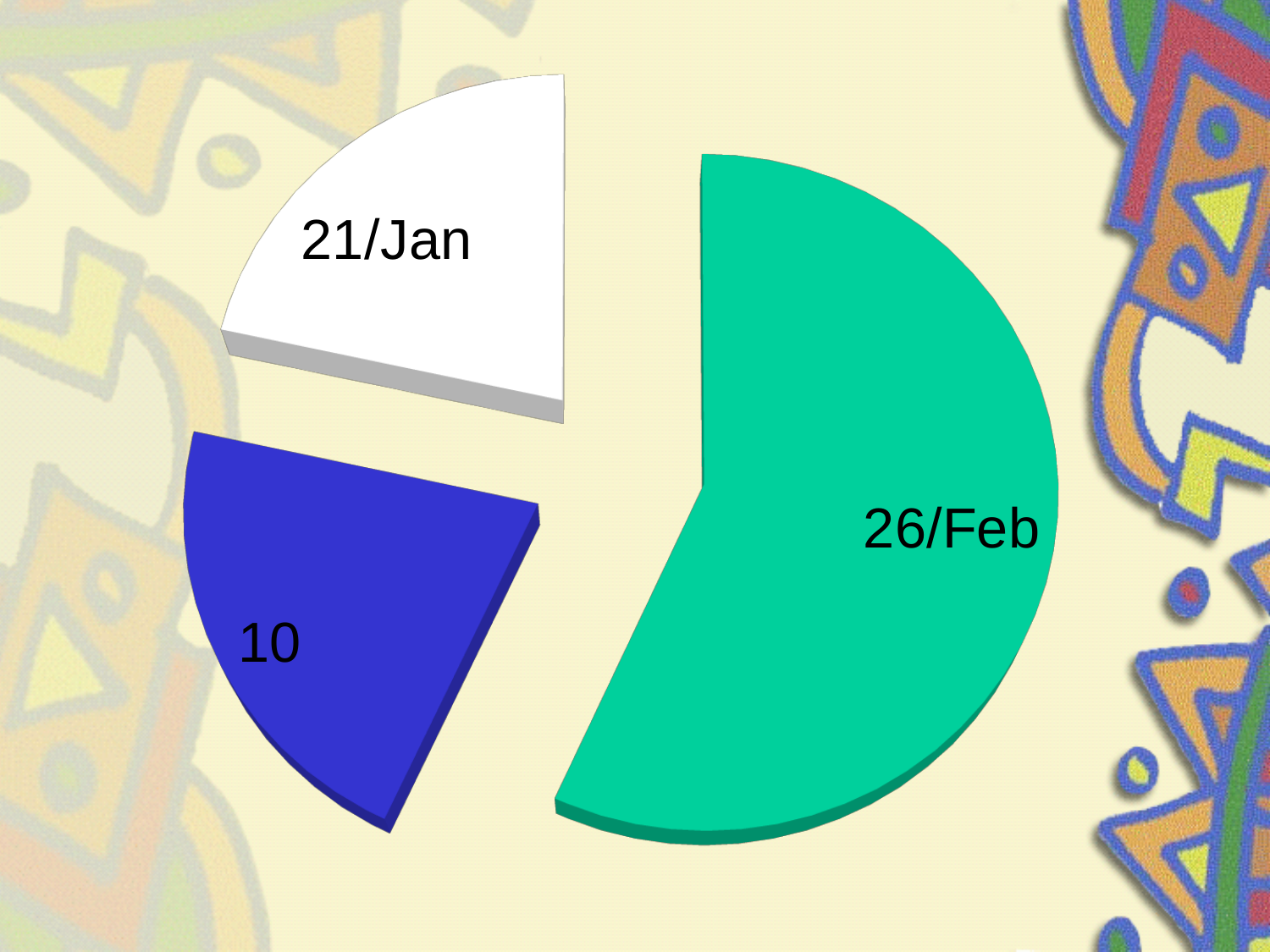
How many slices does the pie chart have? 3 Which slice is larger, 26/Feb or 21/Jan? 26/Feb What kind of chart is shown on the slide? pie chart What colour is the slice labelled 26/Feb? green Which slice is larger, 26/Feb or 10? 26/Feb Which slice of the pie chart is the largest? 26/Feb What colour is the slice labelled 21/Jan? white Does the 26/Feb slice take up more or less than half of the pie? more